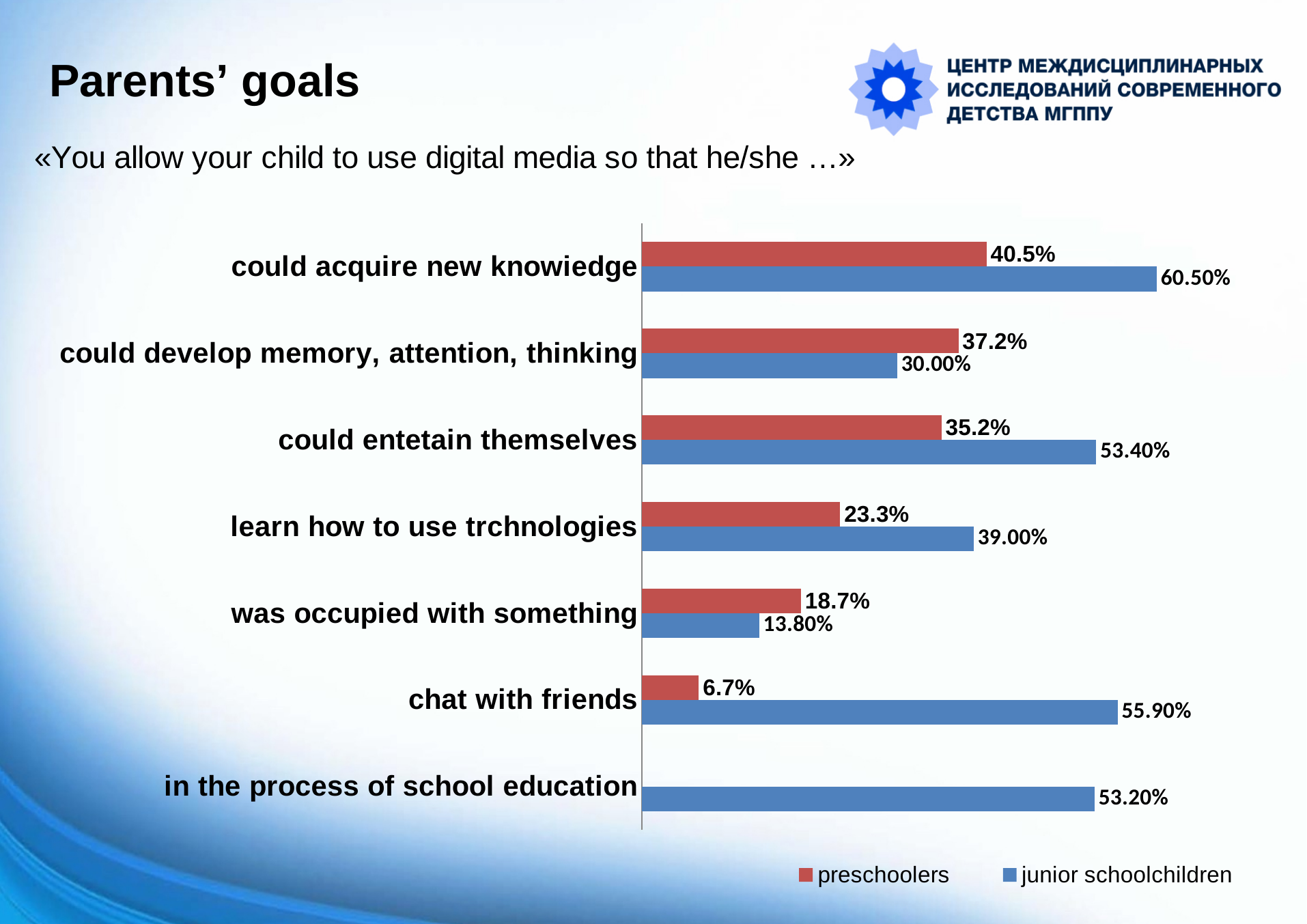
Which category has the highest value for junior schoolchildren? could acquire new knowiedge Which category has the lowest value for preschoolers? chat with friends What is the difference between junior schoolchildren and preschoolers for "could acquire new knowiedge"? 20% What is the value for preschoolers for "could acquire new knowiedge"? 40.5% What is the value for junior schoolchildren for "in the process of school education"? 53.20% How many categories are shown on the chart? 7 Which colour represents junior schoolchildren in the chart? blue For "was occupied with something", which series has the larger value, preschoolers or junior schoolchildren? preschoolers For "could develop memory, attention, thinking", which series has the larger value, preschoolers or junior schoolchildren? preschoolers How many series does the legend list? 2 What kind of chart is shown on the slide? bar chart What is the value for junior schoolchildren for "chat with friends"? 55.90%